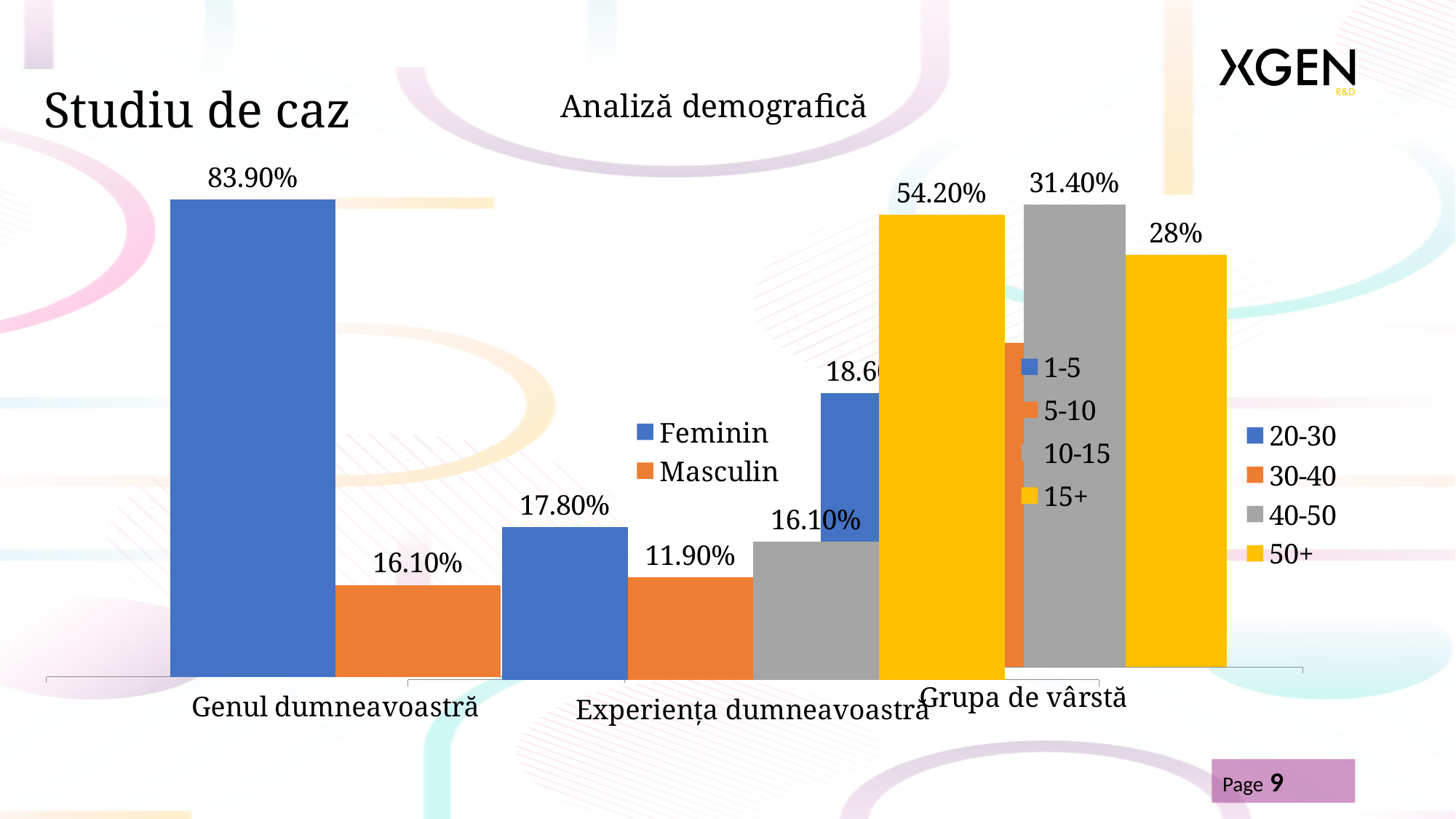
How many series does the legend of the 'Genul dumneavoastră' chart list? 2 In the 'Experiența dumneavoastră' chart, what is the value for 5-10? 11.90% In the 'Experiența dumneavoastră' chart, which category has the highest value? 15+ In the 'Experiența dumneavoastră' chart, what is the value for 1-5? 17.80% In the 'Genul dumneavoastră' chart, what is the value for Masculin? 16.10% In the 'Grupa de vârstă' chart, which is larger, the value for 40-50 or the value for 50+? 40-50 In the 'Experiența dumneavoastră' chart, what is the value for 15+? 54.20% In the 'Genul dumneavoastră' chart, what is the value for Feminin? 83.90% What kind of chart is the 'Grupa de vârstă' chart? bar chart In the 'Grupa de vârstă' chart, what is the value for 40-50? 31.40% In the 'Genul dumneavoastră' chart, what is the difference between the Feminin and Masculin values? 67.80% In the 'Experiența dumneavoastră' chart, which category has the lowest value? 5-10